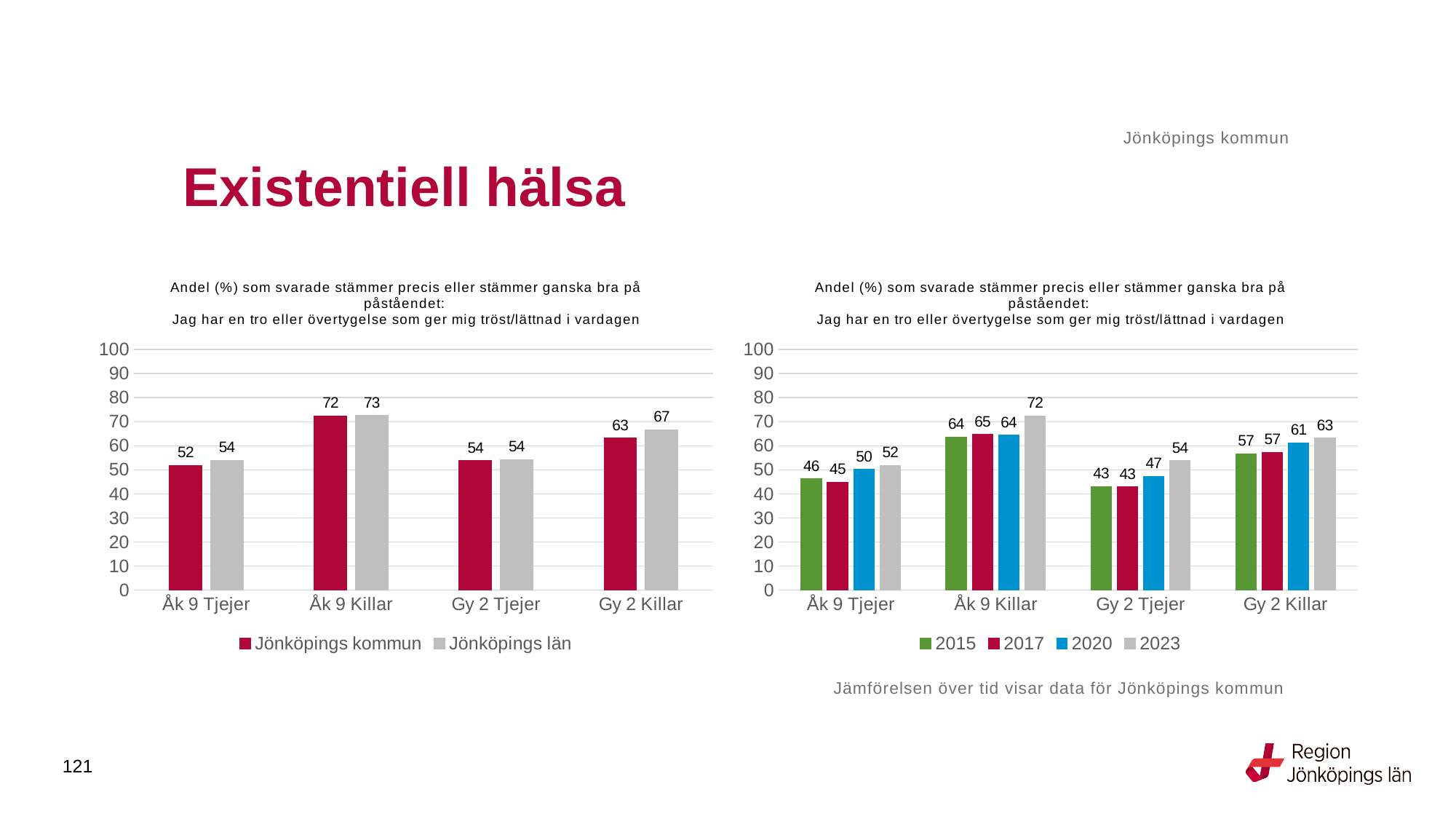
In the right chart, what is the difference between the 2023 and 2015 values for Åk 9 Killar? 8 In the right chart, is the value for 2020 for Gy 2 Killar larger or smaller than the value for 2017 for Gy 2 Killar? larger In the left chart, which category has the highest value for Jönköpings län? Åk 9 Killar In the left chart, how many series does the legend list? 2 In the right chart, how many series does the legend list? 4 In the left chart, what is the value for Jönköpings kommun for Åk 9 Killar? 72 In the right chart, what is the value for 2023 for Gy 2 Tjejer? 54 What kind of chart is the right chart? bar chart In the right chart, what is the value for 2015 for Åk 9 Tjejer? 46 In the left chart, what is the value for Jönköpings län for Gy 2 Killar? 67 In the left chart, what is the difference between Jönköpings län and Jönköpings kommun for Gy 2 Killar? 4 In the right chart, which category has the lowest value for 2017? Gy 2 Tjejer